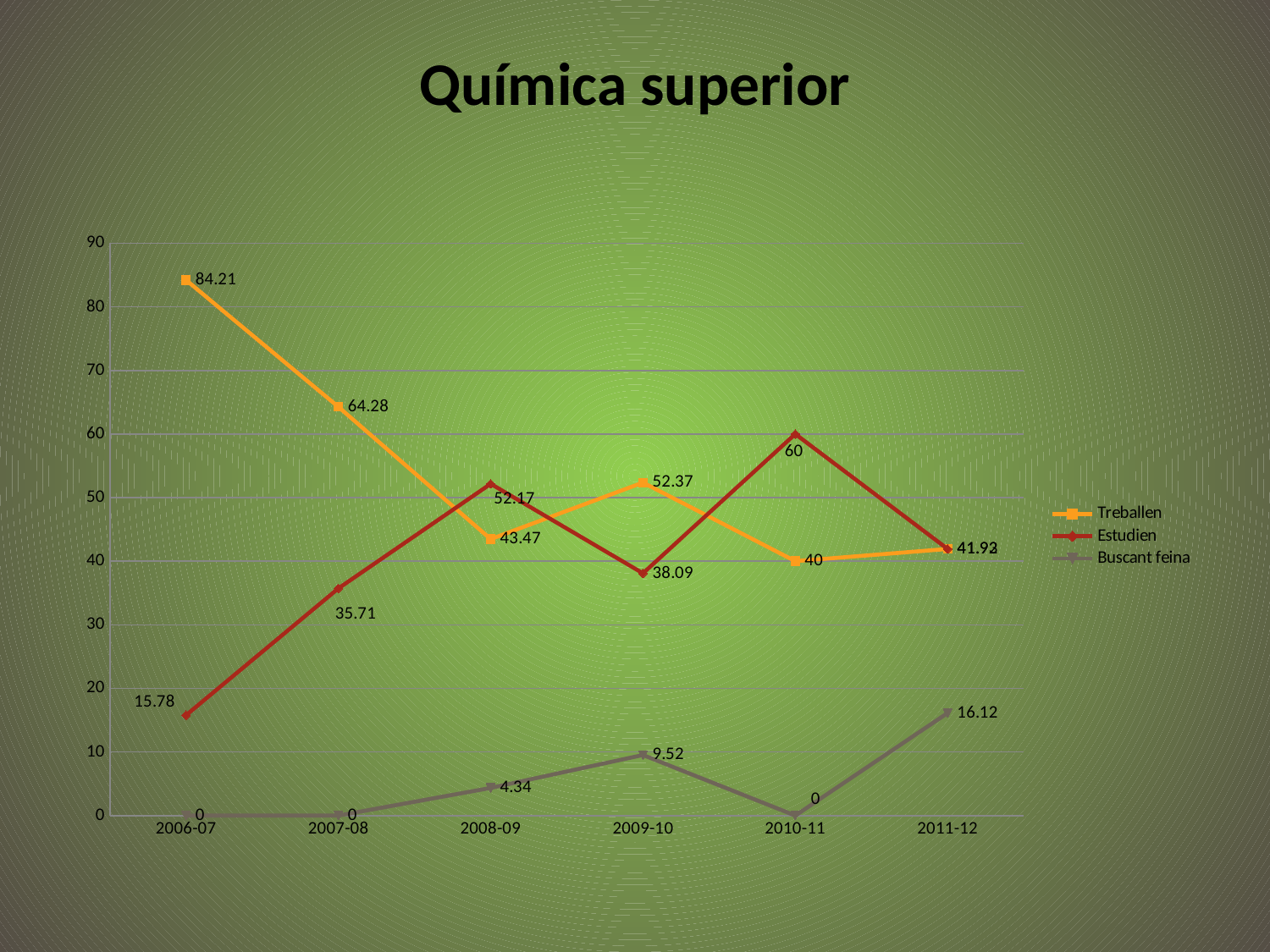
What is the difference between the Treballen values for 2006-07 and 2007-08? 19.93 In 2008-09, which series has the larger value, Treballen or Estudien? Estudien What is the value for Estudien in 2010-11? 60 Does the Treballen series rise or fall from 2006-07 to 2008-09? fall What is the value for Treballen in 2006-07? 84.21 How many academic years are shown on the x axis? 6 In which year is the Treballen series highest? 2006-07 How many series does the legend list? 3 What is the value for Buscant feina in 2011-12? 16.12 Is the value for Estudien in 2007-08 greater or less than 40? less In which year is the Estudien series lowest? 2006-07 What kind of chart is shown on the slide? line chart